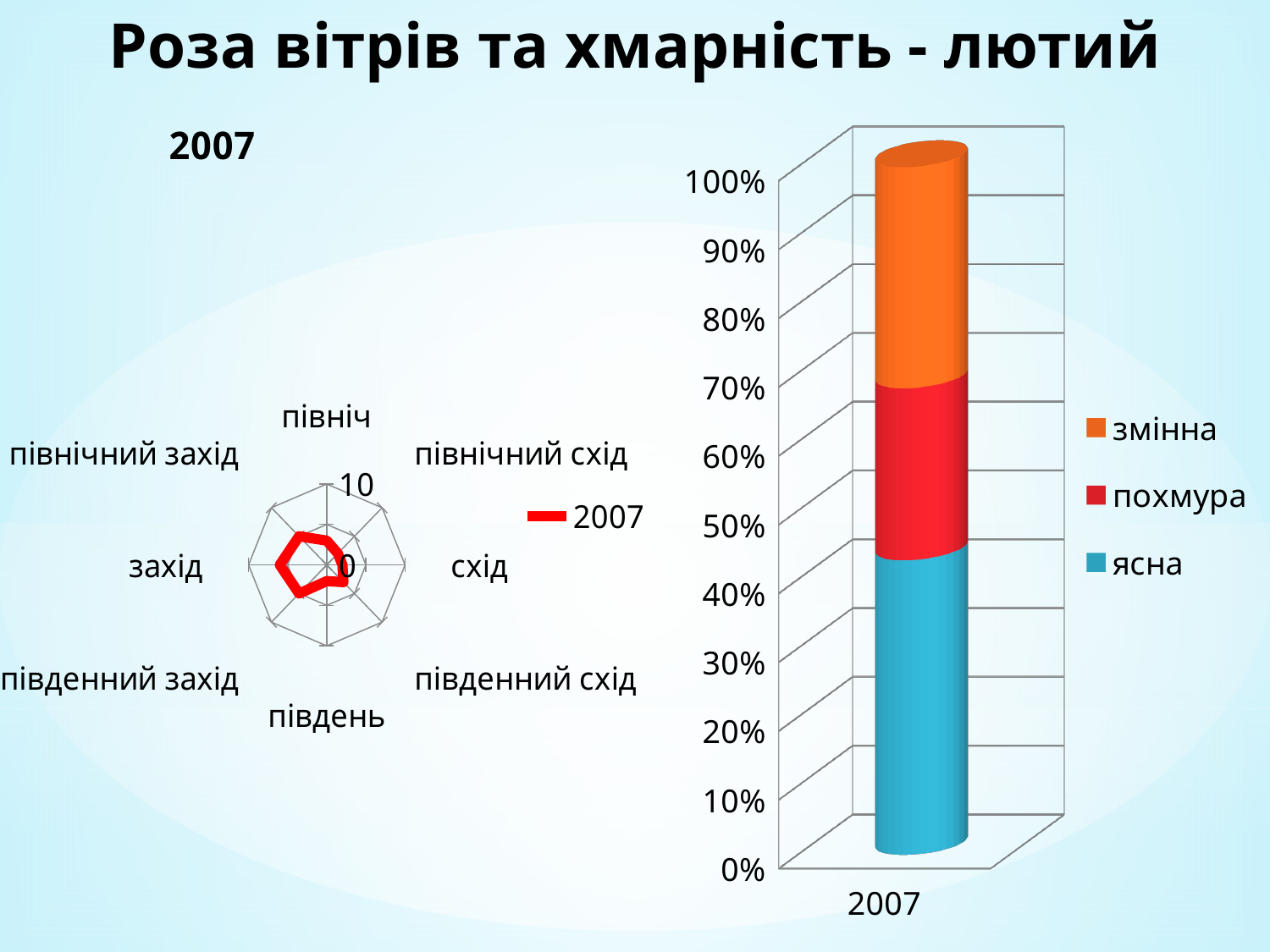
How many series does the legend of the right-hand bar chart list? 3 In the right-hand bar chart, which colour represents the series змінна? orange How many categories are shown on the x axis of the right-hand bar chart? 1 In the left-hand radar chart, which direction has the highest value? захід How many directions (categories) are shown on the left-hand radar chart? 8 In the left-hand radar chart, is the value for захід greater or less than 10? less In the right-hand bar chart, which series has the largest segment in the 2007 bar? ясна In the right-hand bar chart, is the value for ясна greater or less than 30%? greater In the right-hand bar chart, is the value for ясна greater or less than 60%? less What are the legend entries of the right-hand bar chart? змінна, похмура, ясна What kind of chart is the chart on the right side of the slide? bar chart What kind of chart is the chart on the left side of the slide (titled 2007)? radar chart